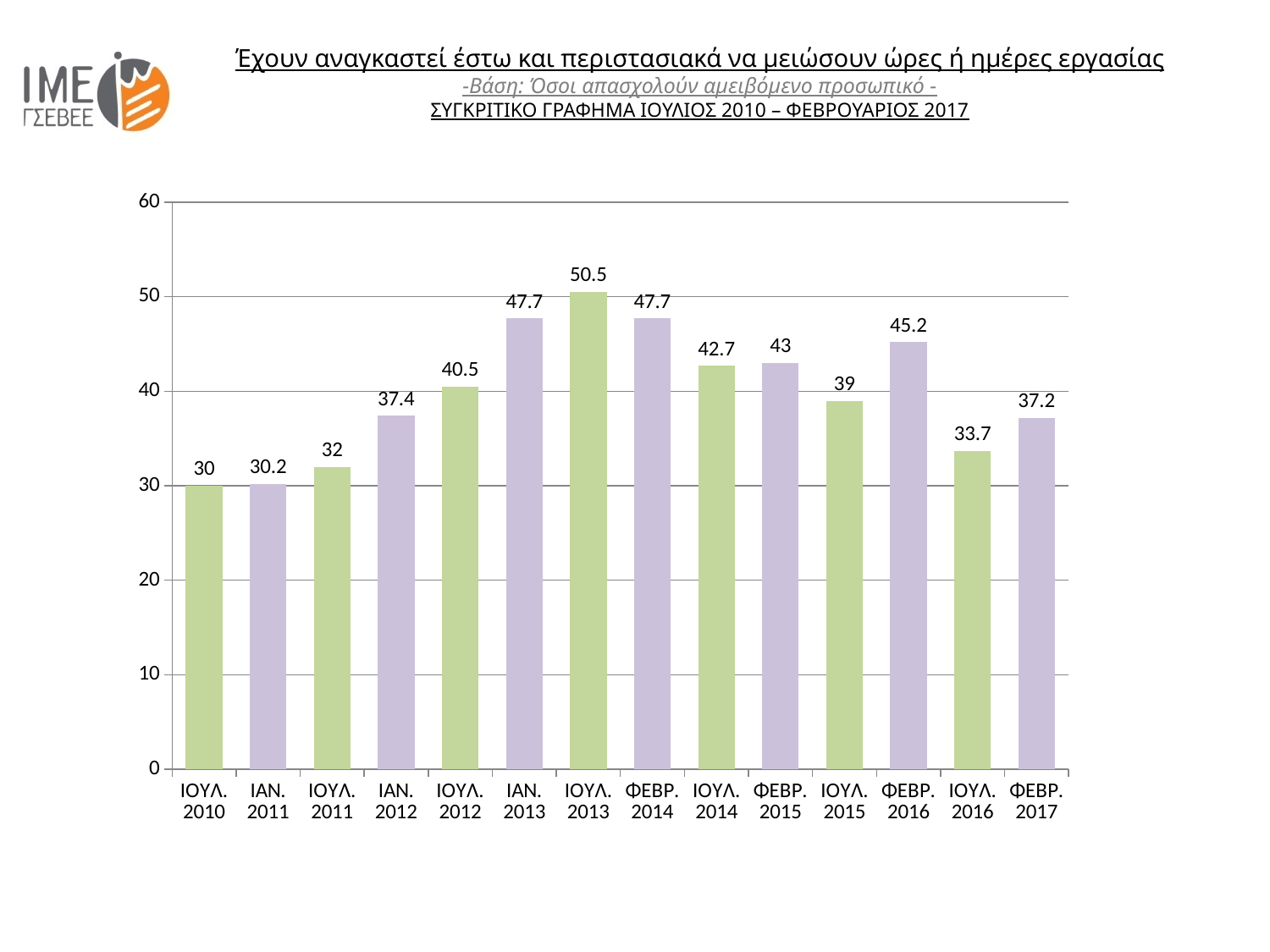
Do the values rise or fall from ΙΟΥΛ. 2010 to ΙΟΥΛ. 2013? rise What is the value for ΦΕΒΡ. 2017? 37.2 What is the value for ΙΟΥΛ. 2013? 50.5 How many periods are shown on the x axis? 14 What kind of chart is shown on the slide? bar chart What is the difference between the values for ΦΕΒΡ. 2016 and ΙΟΥΛ. 2016? 11.5 What is the difference between the values for ΙΟΥΛ. 2013 and ΙΟΥΛ. 2010? 20.5 Is the value for ΙΟΥΛ. 2012 greater or less than 40? greater Which is larger, the value for ΦΕΒΡ. 2015 or the value for ΙΟΥΛ. 2015? ΦΕΒΡ. 2015 Which period has the highest value? ΙΟΥΛ. 2013 What is the value for ΙΑΝ. 2012? 37.4 Which period has the lowest value? ΙΟΥΛ. 2010